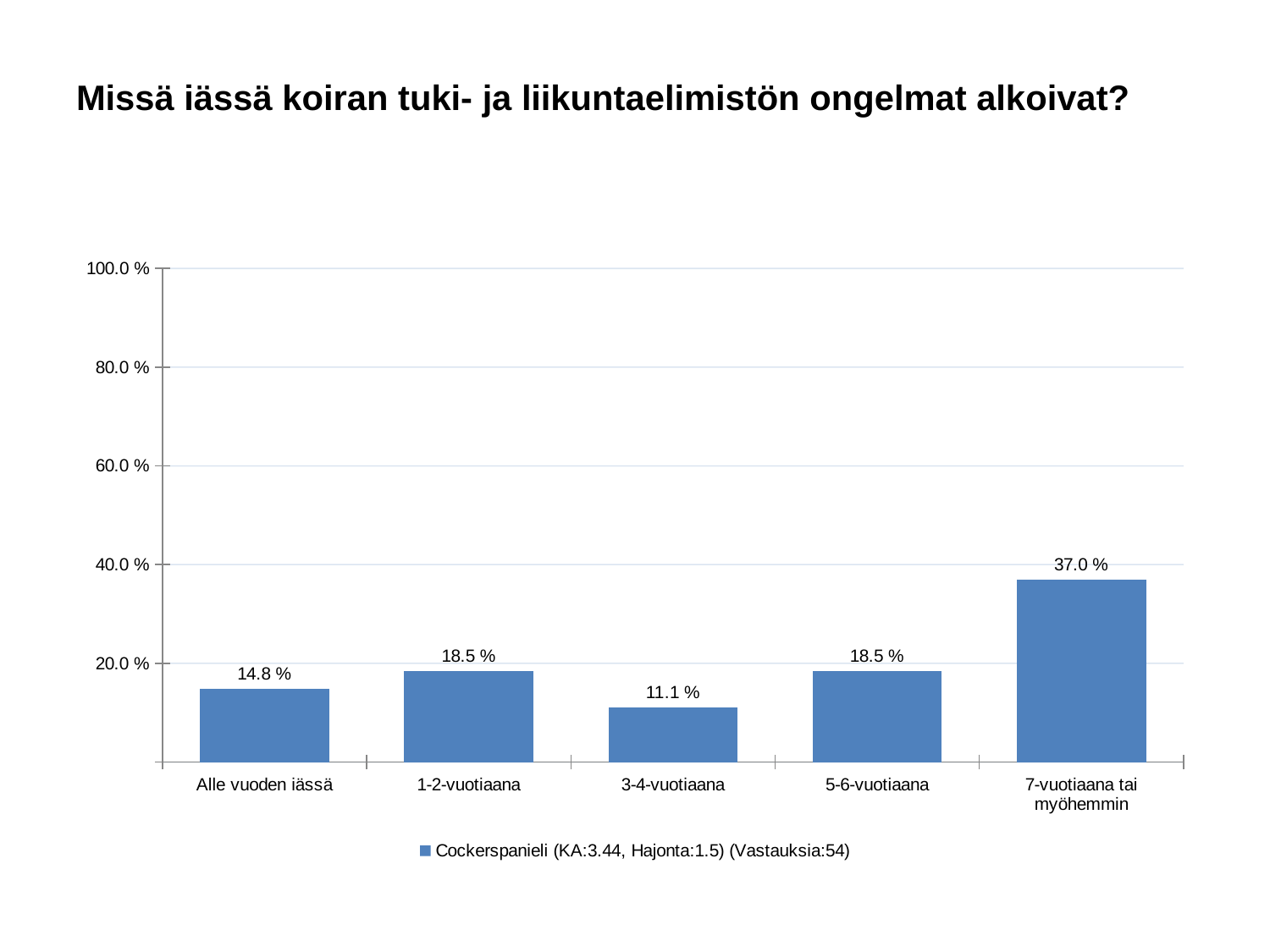
How many series does the legend list? 1 How many categories are shown on the x axis? 5 Which category has the highest value? 7-vuotiaana tai myöhemmin Is the value for "7-vuotiaana tai myöhemmin" greater or less than 40.0 %? less Which category has the lowest value? 3-4-vuotiaana What is the value for "Alle vuoden iässä"? 14.8 % What is the title of the chart? Missä iässä koiran tuki- ja liikuntaelimistön ongelmat alkoivat? What kind of chart is shown on the slide? bar chart What is the difference between the values for "7-vuotiaana tai myöhemmin" and "Alle vuoden iässä"? 22.2 % What is the value for "7-vuotiaana tai myöhemmin"? 37.0 % What is the value for "3-4-vuotiaana"? 11.1 % Which is larger, the value for "1-2-vuotiaana" or the value for "3-4-vuotiaana"? 1-2-vuotiaana